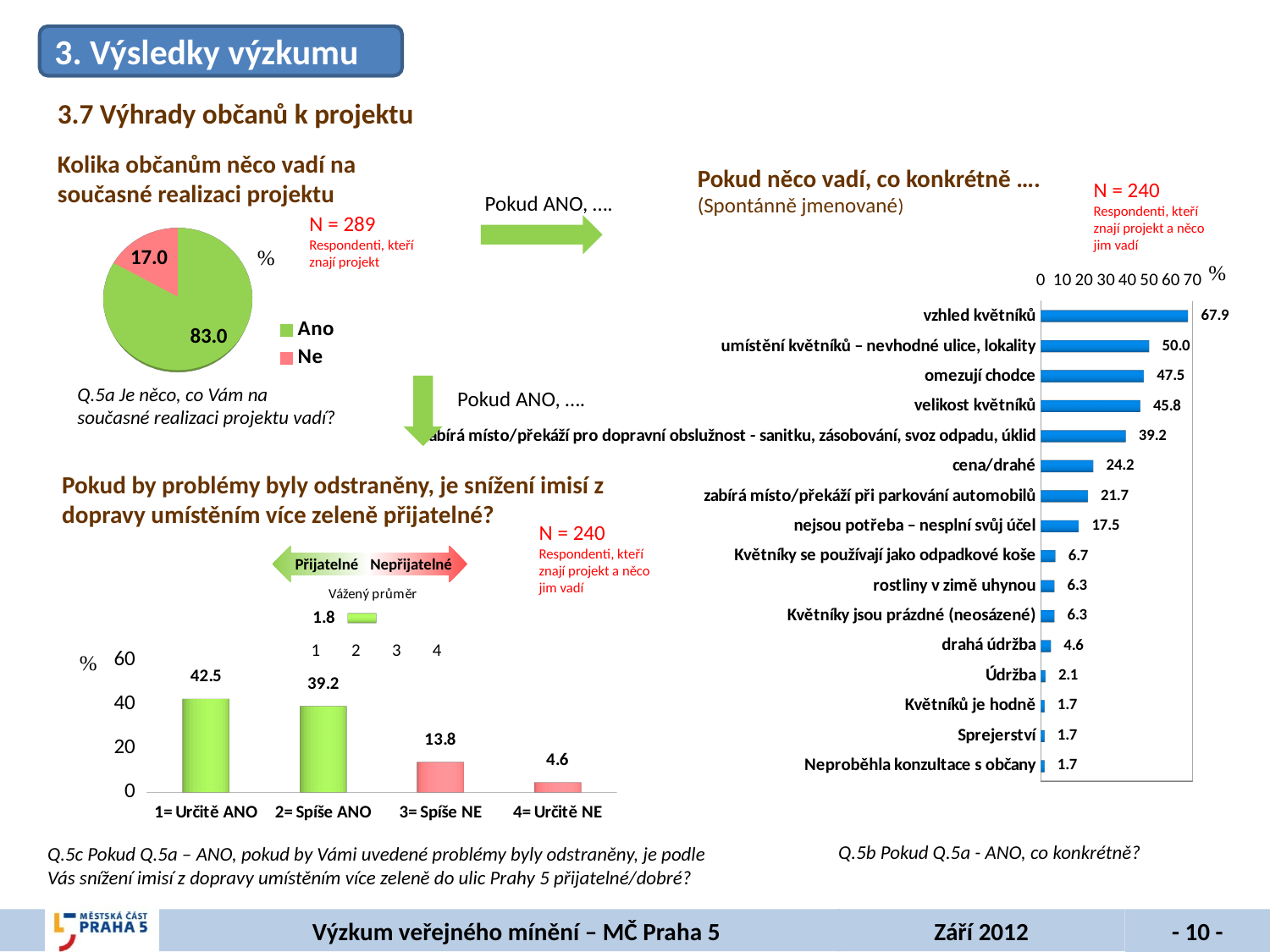
In the chart 'Pokud něco vadí, co konkrétně ….', what is the value for 'vzhled květníků'? 67.9 In the chart 'Pokud něco vadí, co konkrétně ….', which category has the highest value? vzhled květníků In the pie chart 'Kolika občanům něco vadí na současné realizaci projektu', what is the value for 'Ano'? 83.0 In the chart 'Pokud by problémy byly odstraněny, je snížení imisí z dopravy umístěním více zeleně přijatelné?', what is the value for '3= Spíše NE'? 13.8 In the pie chart 'Kolika občanům něco vadí na současné realizaci projektu', what is the value for 'Ne'? 17.0 In the chart 'Pokud něco vadí, co konkrétně ….', which is larger: 'cena/drahé' or 'zabírá místo/překáží při parkování automobilů'? cena/drahé How many series does the legend of the pie chart 'Kolika občanům něco vadí na současné realizaci projektu' list? 2 How many categories are shown in the chart 'Pokud něco vadí, co konkrétně ….'? 16 In the chart 'Pokud něco vadí, co konkrétně ….', what is the difference between 'umístění květníků – nevhodné ulice, lokality' and 'omezují chodce'? 2.5 What kind of chart is 'Pokud něco vadí, co konkrétně ….'? bar chart In the chart 'Pokud by problémy byly odstraněny, je snížení imisí z dopravy umístěním více zeleně přijatelné?', which category has the lowest value? 4= Určitě NE In the chart 'Pokud by problémy byly odstraněny, je snížení imisí z dopravy umístěním více zeleně přijatelné?', do the values rise or fall from left to right along the x axis? fall